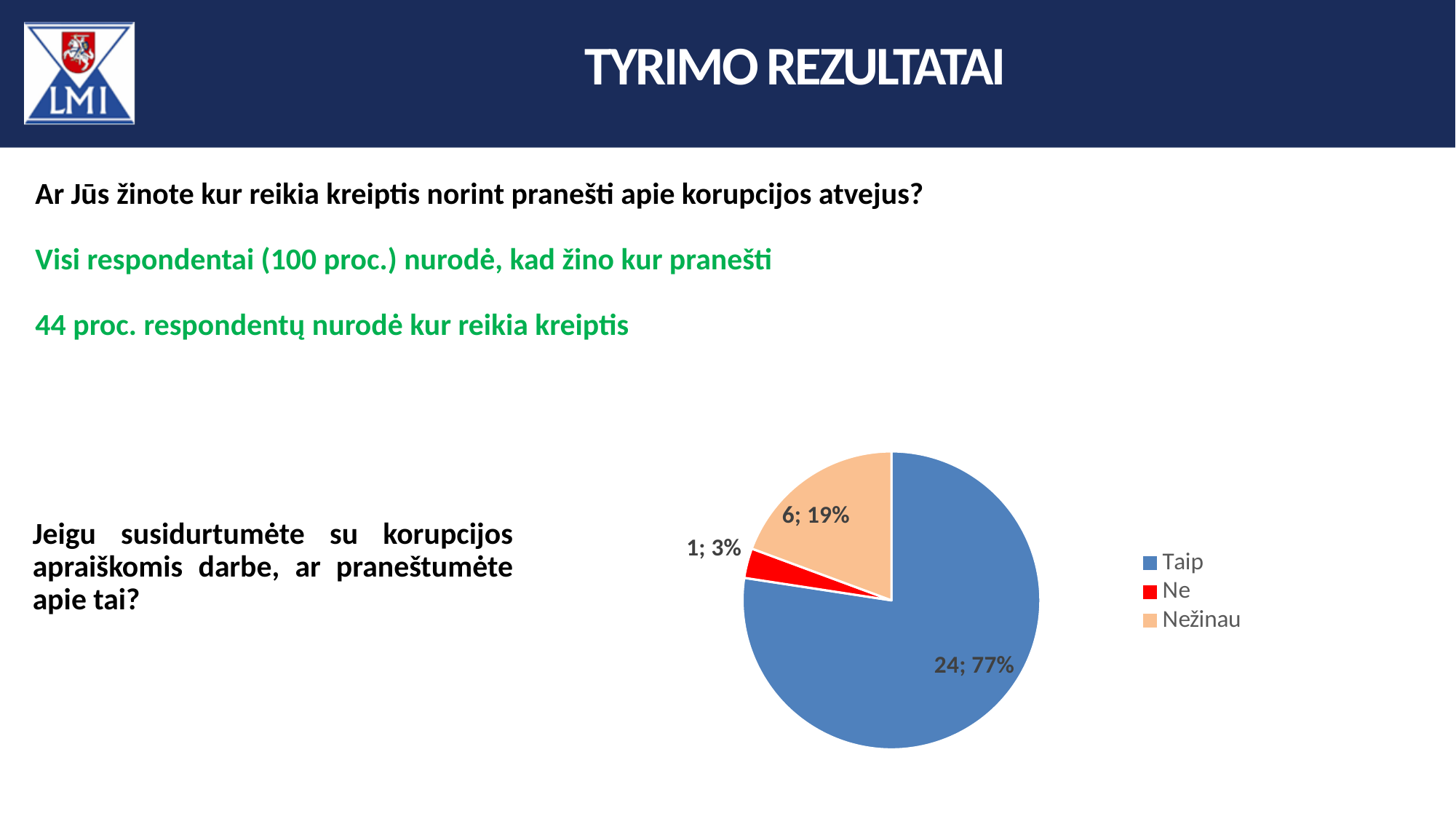
What percentage share does the "Ne" slice have in the pie chart? 3% What colour is the "Ne" slice in the pie chart? red How many respondents answered "Nežinau" in the pie chart? 6 What is the difference in respondent count between "Taip" and "Nežinau" in the pie chart? 18 Which slice is larger in the pie chart, "Ne" or "Nežinau"? Nežinau How many categories does the pie chart show? 3 What percentage share does the "Nežinau" slice have in the pie chart? 19% How many respondents answered "Taip" in the pie chart? 24 What is the total number of respondents across all slices of the pie chart? 31 What kind of chart is shown on the slide? pie chart Which category has the smallest slice in the pie chart? Ne Which category has the largest slice in the pie chart? Taip